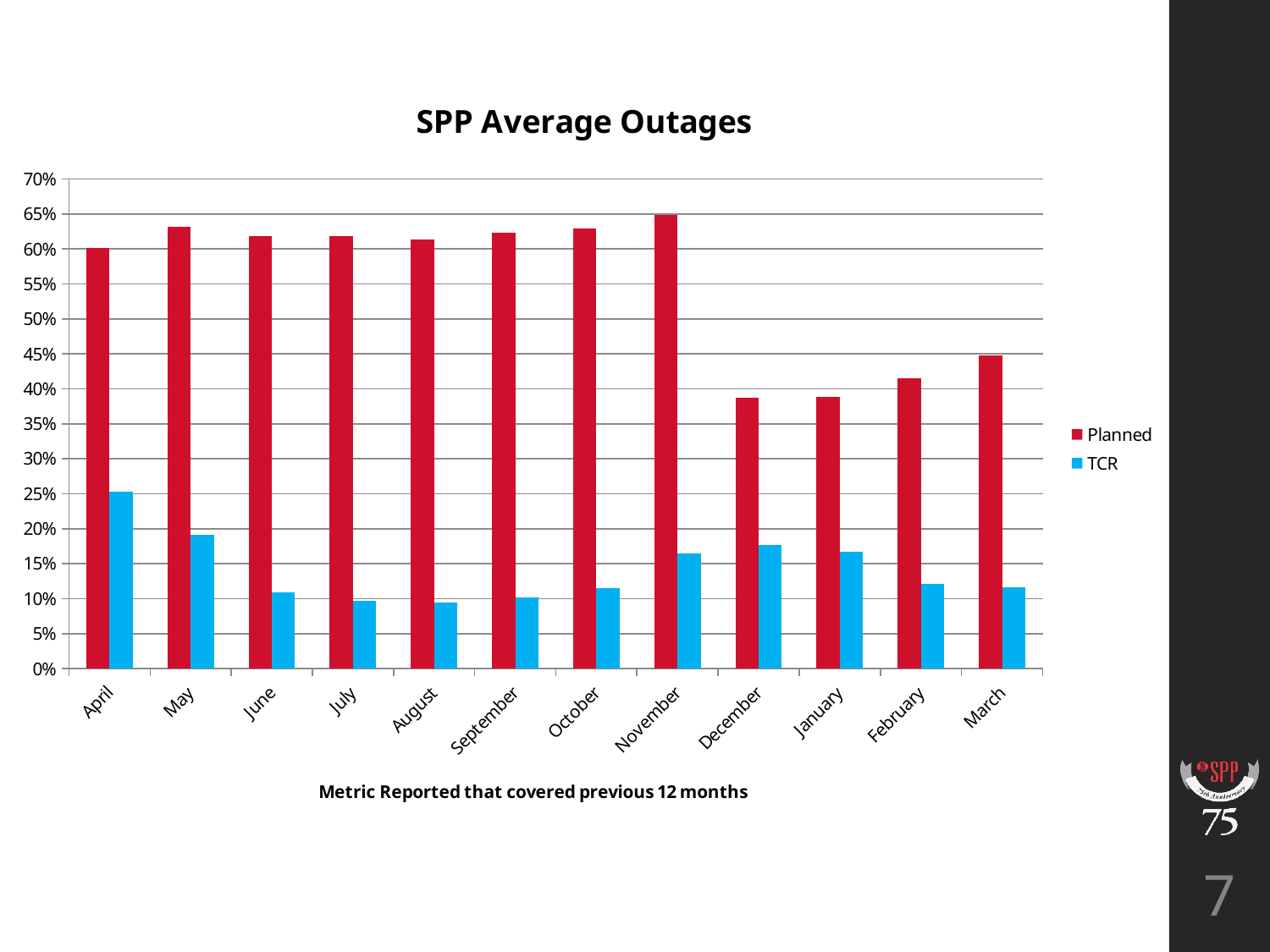
What is the title of the chart? SPP Average Outages Is the Planned value for March greater or less than 50%? less Is the TCR value for April greater or less than 20%? greater How many months are shown on the x axis? 12 Is the Planned value for April greater or less than 55%? greater What type of chart is shown on the slide? bar chart Which colour represents the TCR series in the legend? blue Which month has the highest TCR value? April Which is larger, the Planned value for November or the Planned value for December? November How many series does the legend list? 2 Which month has the highest Planned value? November